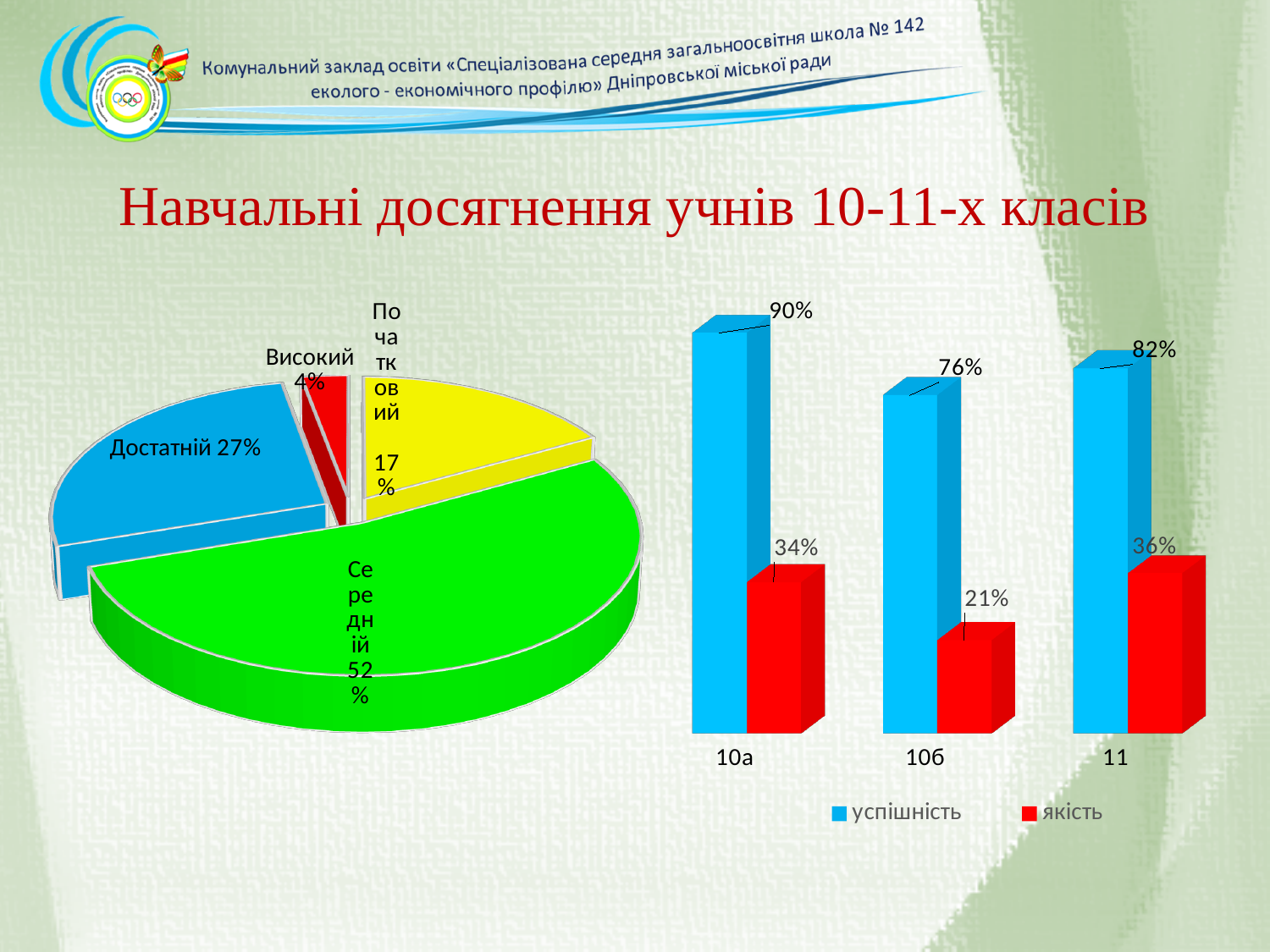
In the bar chart on the right, what is the якість value for 10б? 21% In the pie chart on the left, what share does the Середній slice have? 52% In the pie chart on the left, which category has the smallest slice? Високий In the pie chart on the left, what share does the Високий slice have? 4% In the pie chart on the left, how many slices are there? 4 In the bar chart on the right, what is the успішність value for 10а? 90% In the pie chart on the left, what is the difference between the Достатній and Початковий shares? 10% In the bar chart on the right, how many series does the legend list? 2 In the bar chart on the right, which class has the lowest успішність value? 10б In the bar chart on the right, what is the difference between the успішність and якість values for 11? 46% What kind of chart is shown on the right side of the slide? Bar chart In the pie chart on the left, which category has the largest slice? Середній